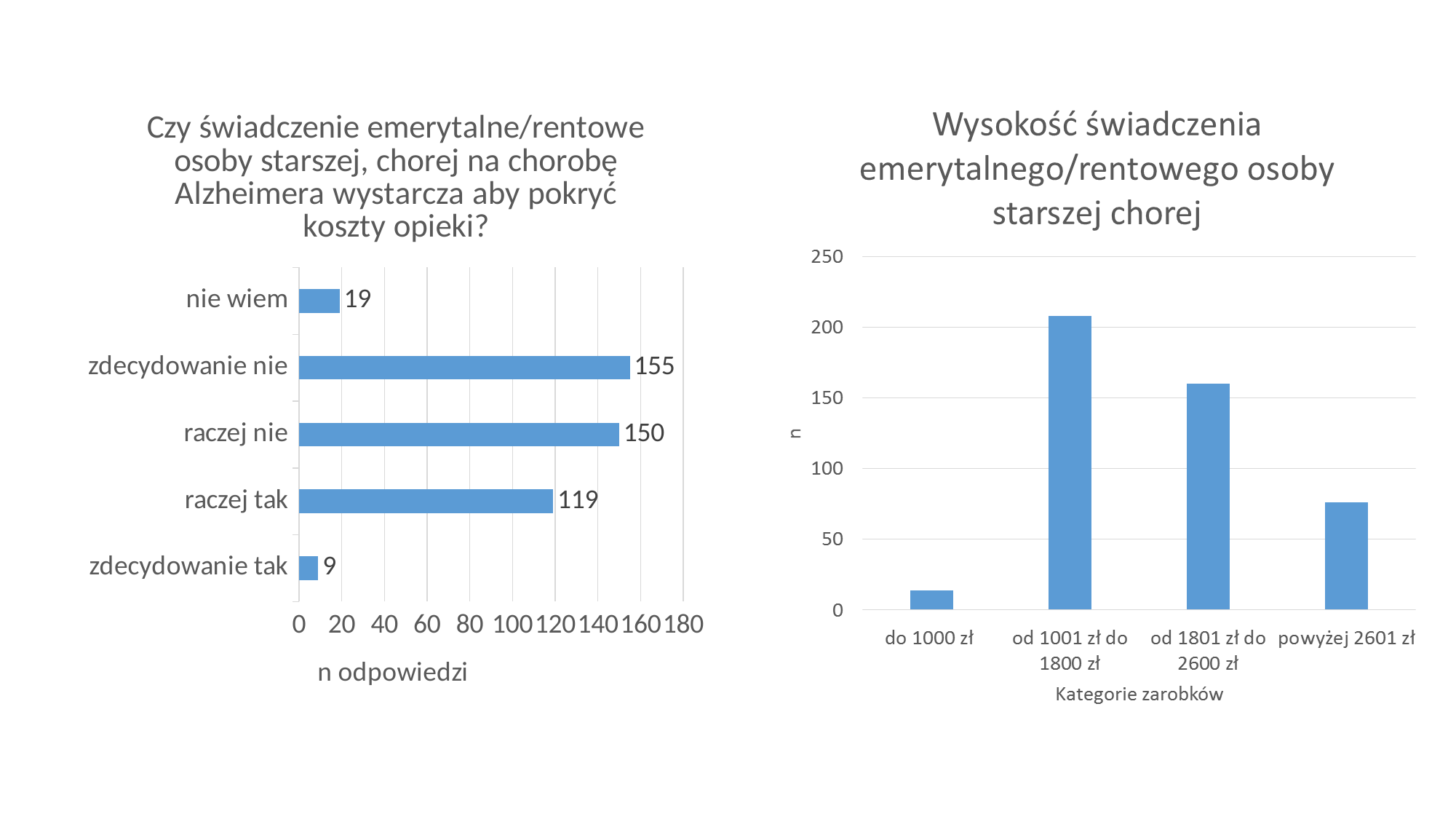
In the right chart, is the value for 'od 1001 zł do 1800 zł' greater or less than 200? greater In the left chart, which is larger: 'nie wiem' or 'zdecydowanie tak'? nie wiem In the left chart, how many responses are there for 'zdecydowanie nie'? 155 What type of chart is the left chart? bar chart In the left chart, which category has the lowest value? zdecydowanie tak How many categories does the left chart show? 5 In the right chart, which income category has the highest bar? od 1001 zł do 1800 zł In the right chart, is the value for 'powyżej 2601 zł' greater or less than 100? less In the left chart, which category has the highest value? zdecydowanie nie In the left chart, what is the value for 'raczej tak'? 119 In the right chart, which income category has the lowest bar? do 1000 zł In the left chart, what is the difference between 'zdecydowanie nie' and 'raczej nie'? 5